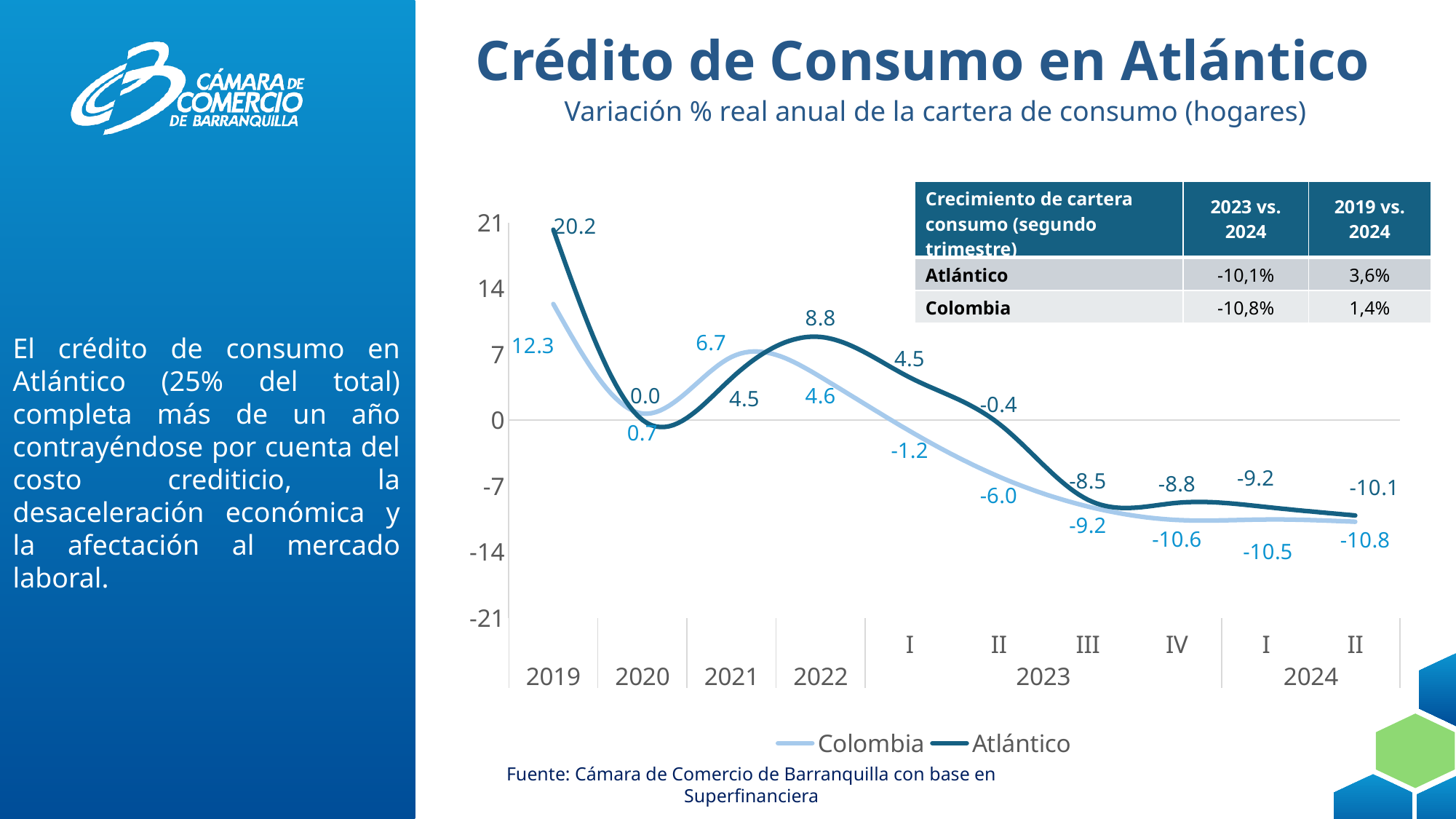
What is the value for Atlántico in 2022? 8.8 What is the value for Colombia in 2019? 12.3 In which period does Atlántico reach its highest value? 2019 What is the difference between the Atlántico and Colombia values in 2019? 7.9 In which period does Colombia reach its lowest value? II 2024 Which series has the higher value in quarter II of 2023, Colombia or Atlántico? Atlántico What is the value for Colombia in quarter IV of 2023? -10.6 What type of chart is shown on the slide? line chart How many series does the chart legend list? 2 Do the Atlántico values rise or fall from 2022 to quarter II of 2024? fall What is the value for Atlántico in quarter II of 2024? -10.1 What is the value for Atlántico in 2019? 20.2